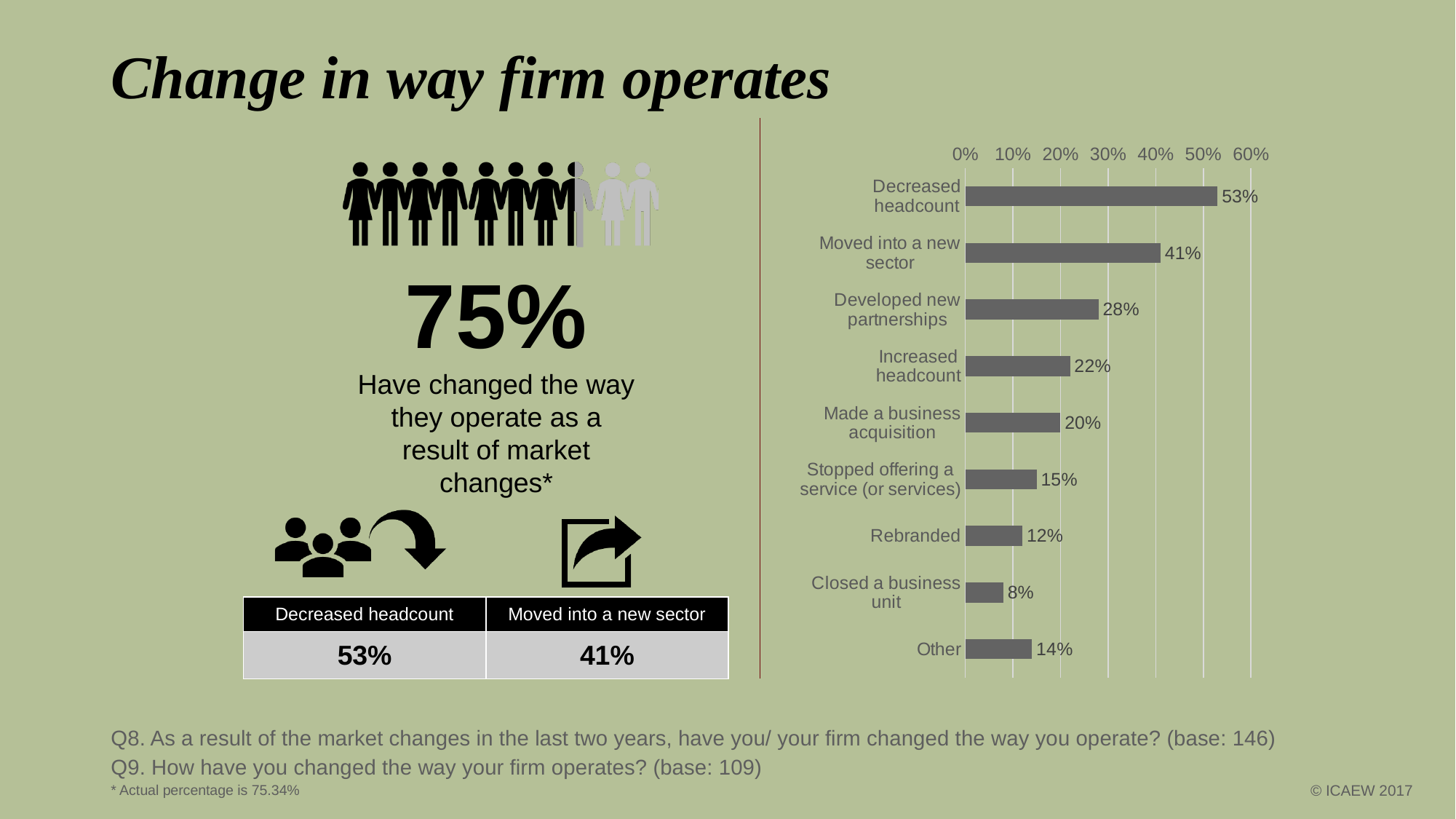
What is the value for 'Developed new partnerships'? 28% Which category has the highest value in the bar chart? Decreased headcount What is the value for 'Closed a business unit'? 8% What is the difference between 'Stopped offering a service (or services)' and 'Rebranded'? 3% What percentage of firms decreased headcount according to the bar chart? 53% What kind of chart is shown on the right of the slide? bar chart What is the value for 'Moved into a new sector' in the bar chart? 41% How many categories are shown in the bar chart? 9 Which category has the lowest value in the bar chart? Closed a business unit Which is larger: 'Rebranded' or 'Other'? Other Is the value for 'Increased headcount' greater or less than 30%? less What is the difference between 'Decreased headcount' and 'Moved into a new sector'? 12%